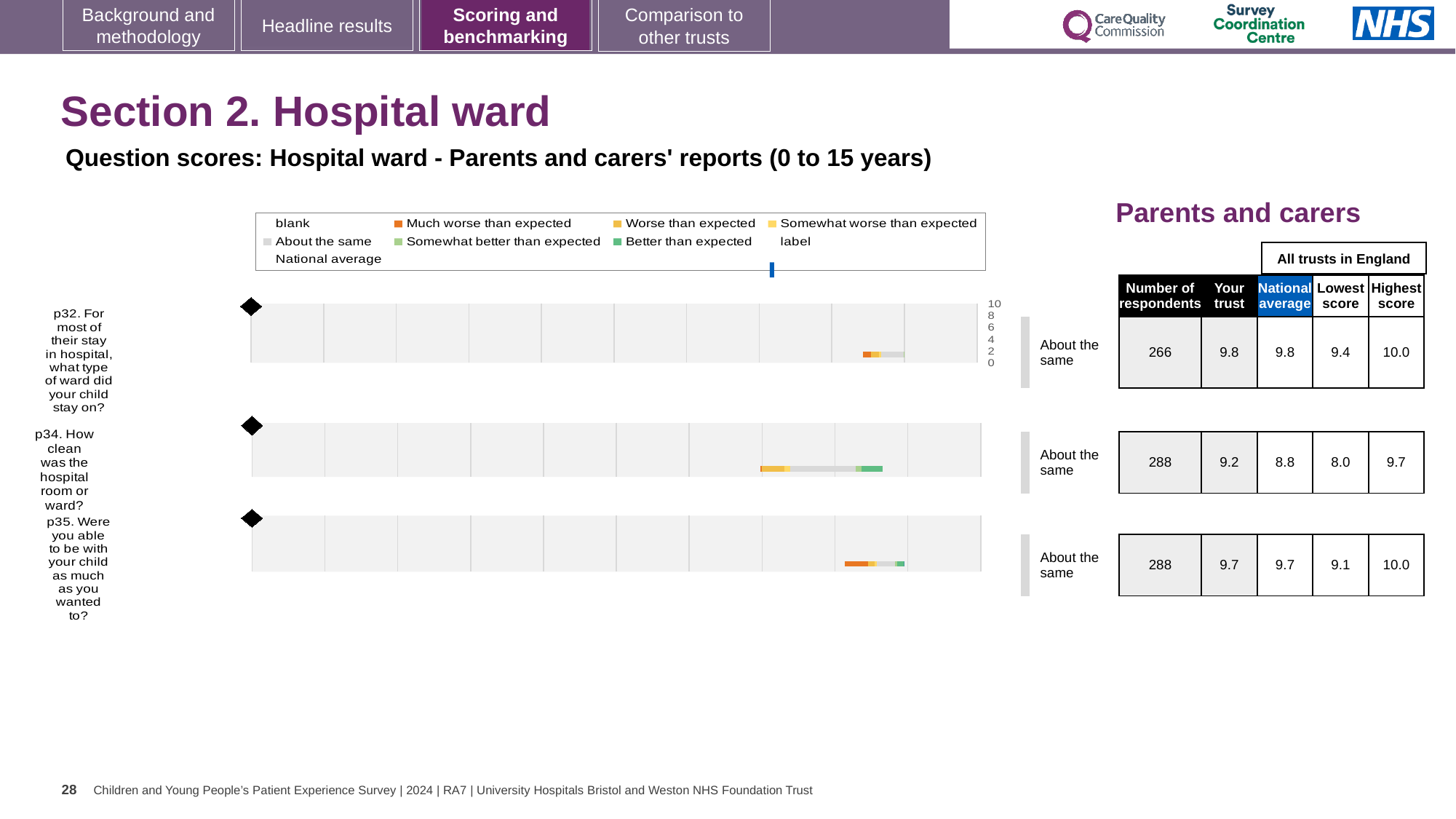
What is the 'Your trust' score for p34 (How clean was the hospital room or ward?)? 9.2 For p34, what is the difference between the Highest score and the Lowest score across all trusts in England? 1.7 Which question has the highest 'Your trust' score on this slide? p32 For p34, which is larger: the 'Your trust' score or the National average? Your trust What kind of chart is used to show the question scores on this slide? bar chart What benchmark category is given for p35 (Were you able to be with your child as much as you wanted to?)? About the same How many respondents answered p32 (what type of ward did your child stay on)? 266 For p32, what is the difference between the Highest score and the 'Your trust' score? 0.2 What is the National average score for p34 (How clean was the hospital room or ward?)? 8.8 How many questions (p32, p34, p35) have a chart plotted on this slide? 3 Which question has the lowest 'Your trust' score on this slide? p34